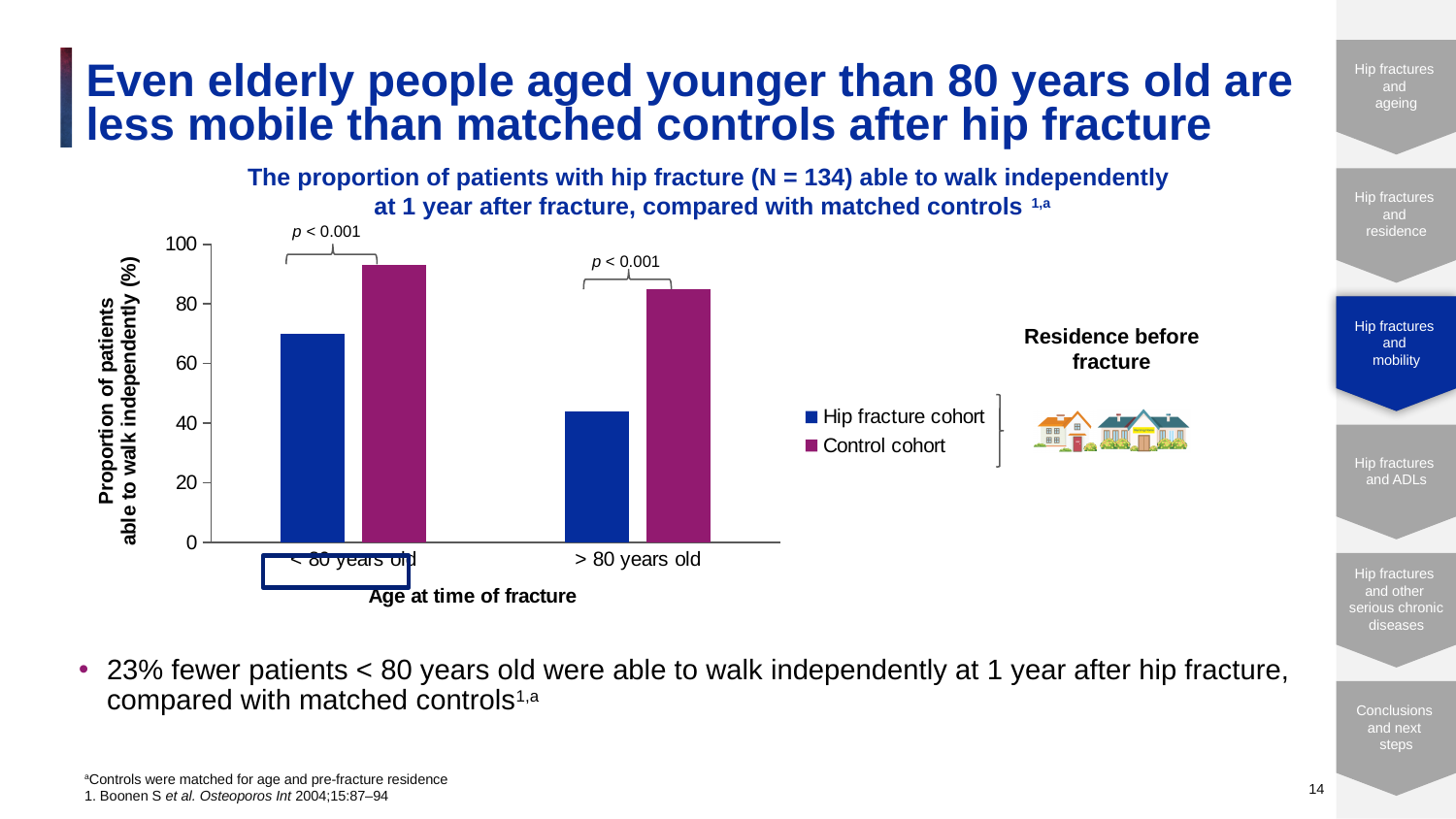
How many age categories are shown on the x axis of the chart? 2 Which bar in the chart is the lowest? Hip fracture cohort, > 80 years old Is the value for the Hip fracture cohort in the < 80 years old group greater or less than 60? greater Is the value for the Control cohort in the < 80 years old group greater or less than 80? greater In the > 80 years old group, which cohort has the larger proportion able to walk independently? Control cohort Is the value for the Control cohort in the > 80 years old group greater or less than 80? greater What colour are the Control cohort bars in the chart? purple Which bar in the chart is the highest? Control cohort, < 80 years old How many series does the chart legend list? 2 What is the label of the x axis of the chart? Age at time of fracture What kind of chart is shown on the slide? bar chart